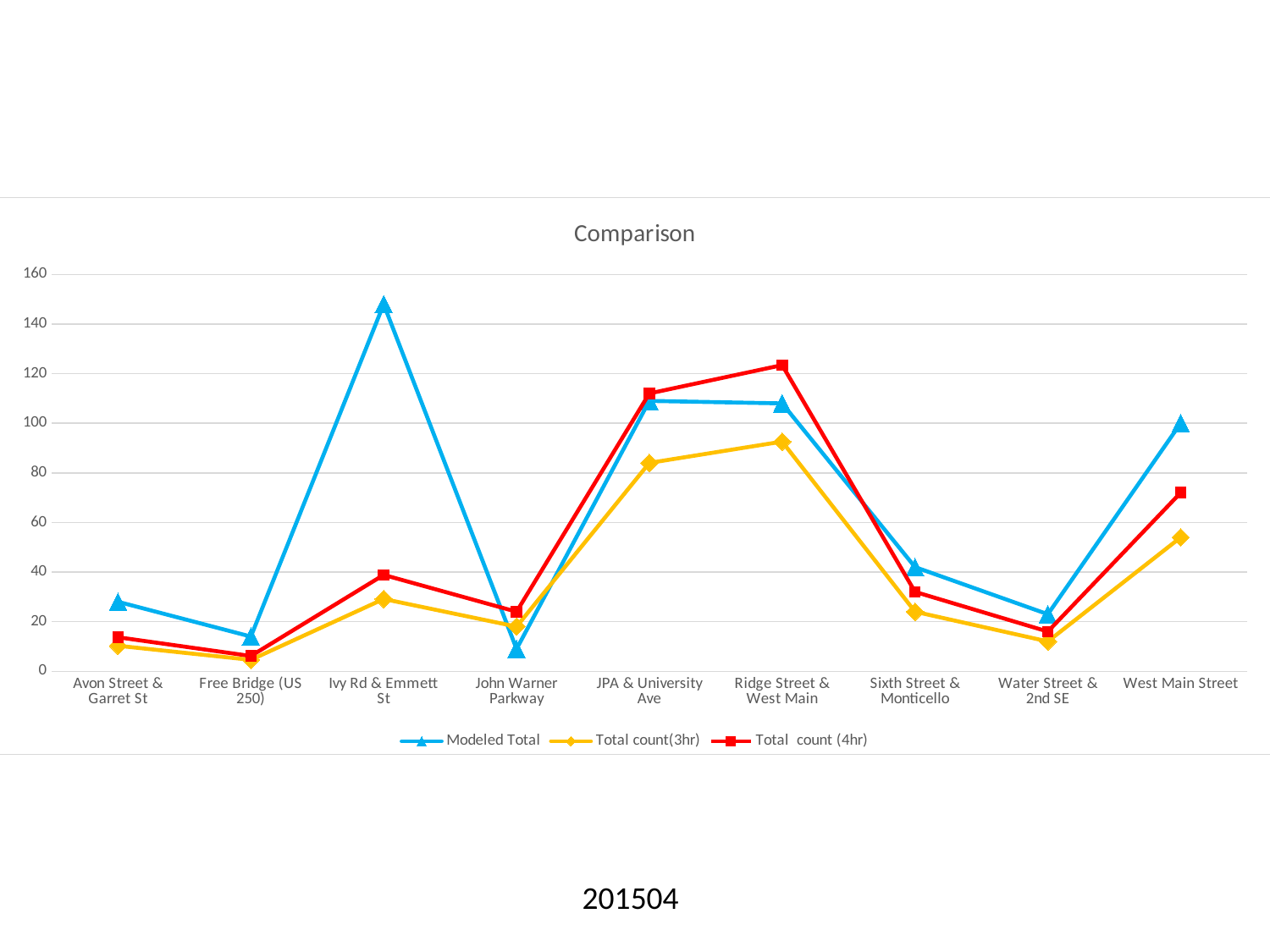
At Ridge Street & West Main, which is larger: the Total count (4hr) or the Total count(3hr)? Total count (4hr) What is the title of the chart? Comparison Is the Total count(3hr) for JPA & University Ave greater or less than 100? less What kind of chart is shown on the slide? line chart How many intersections (categories) are plotted along the x axis? 9 For which intersection is the Total count(3hr) lowest? Free Bridge (US 250) For which intersection is the Modeled Total highest? Ivy Rd & Emmett St At John Warner Parkway, which is larger: the Modeled Total or the Total count (4hr)? Total count (4hr) How many series does the legend of the chart list? 3 Is the Modeled Total for Ivy Rd & Emmett St greater or less than 140? greater For which intersection is the Total count (4hr) highest? Ridge Street & West Main Is the Total count (4hr) for West Main Street greater or less than 60? greater